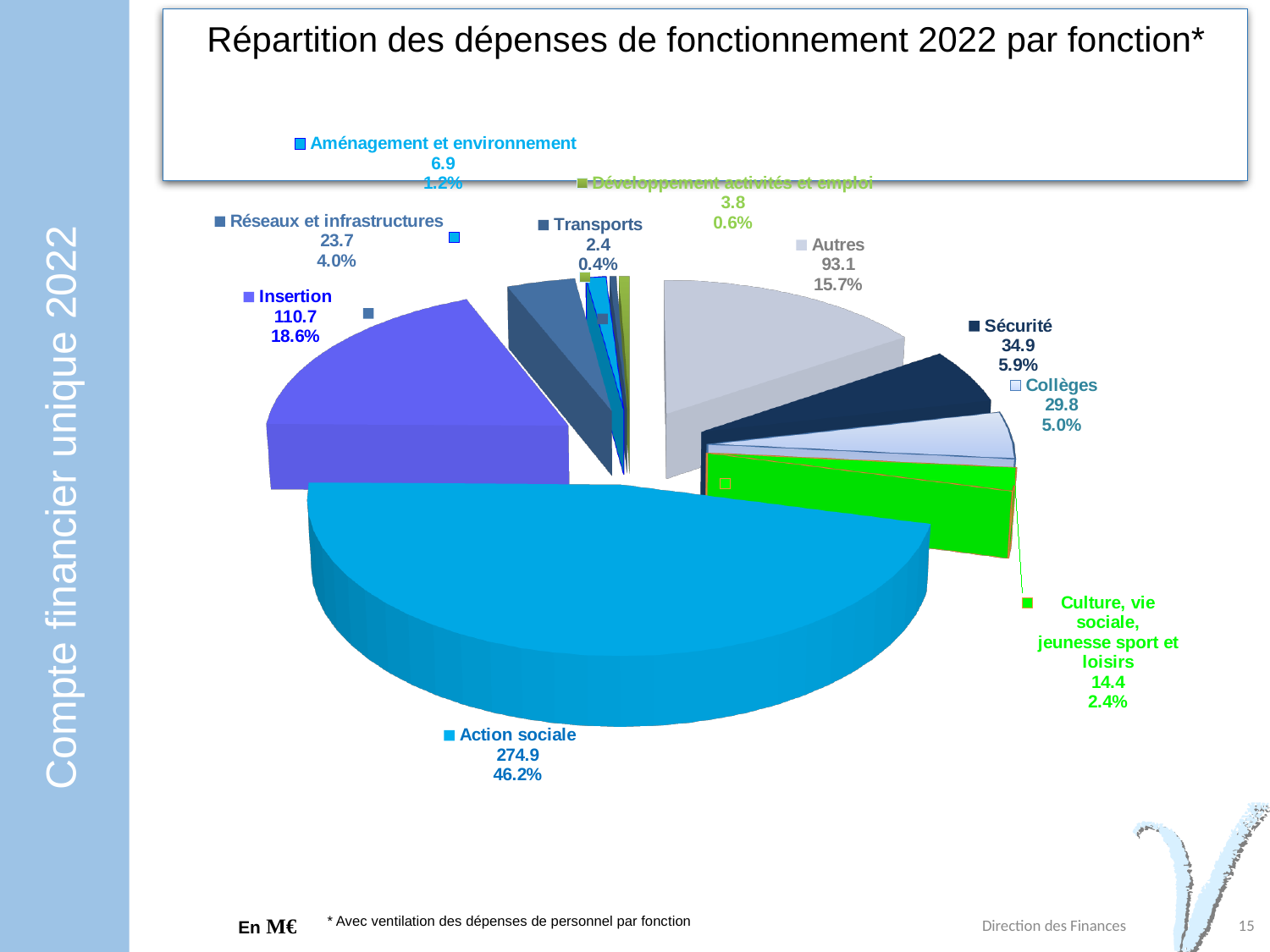
What is the value for Culture, vie sociale, jeunesse sport et loisirs? 14.4 What is the title of the chart? Répartition des dépenses de fonctionnement 2022 par fonction* How many categories are shown in the pie chart? 10 What is the value for Autres? 93.1 Which category has the largest slice of the pie? Action sociale What is the value for Action sociale? 274.9 What is the difference between the values for Insertion and Autres? 17.6 Which is larger, the value for Collèges or the value for Sécurité? Sécurité What kind of chart is shown on the slide? pie chart What percentage is shown for Sécurité? 5.9% What share of the pie does Insertion represent? 18.6% Which category has the smallest slice of the pie? Transports